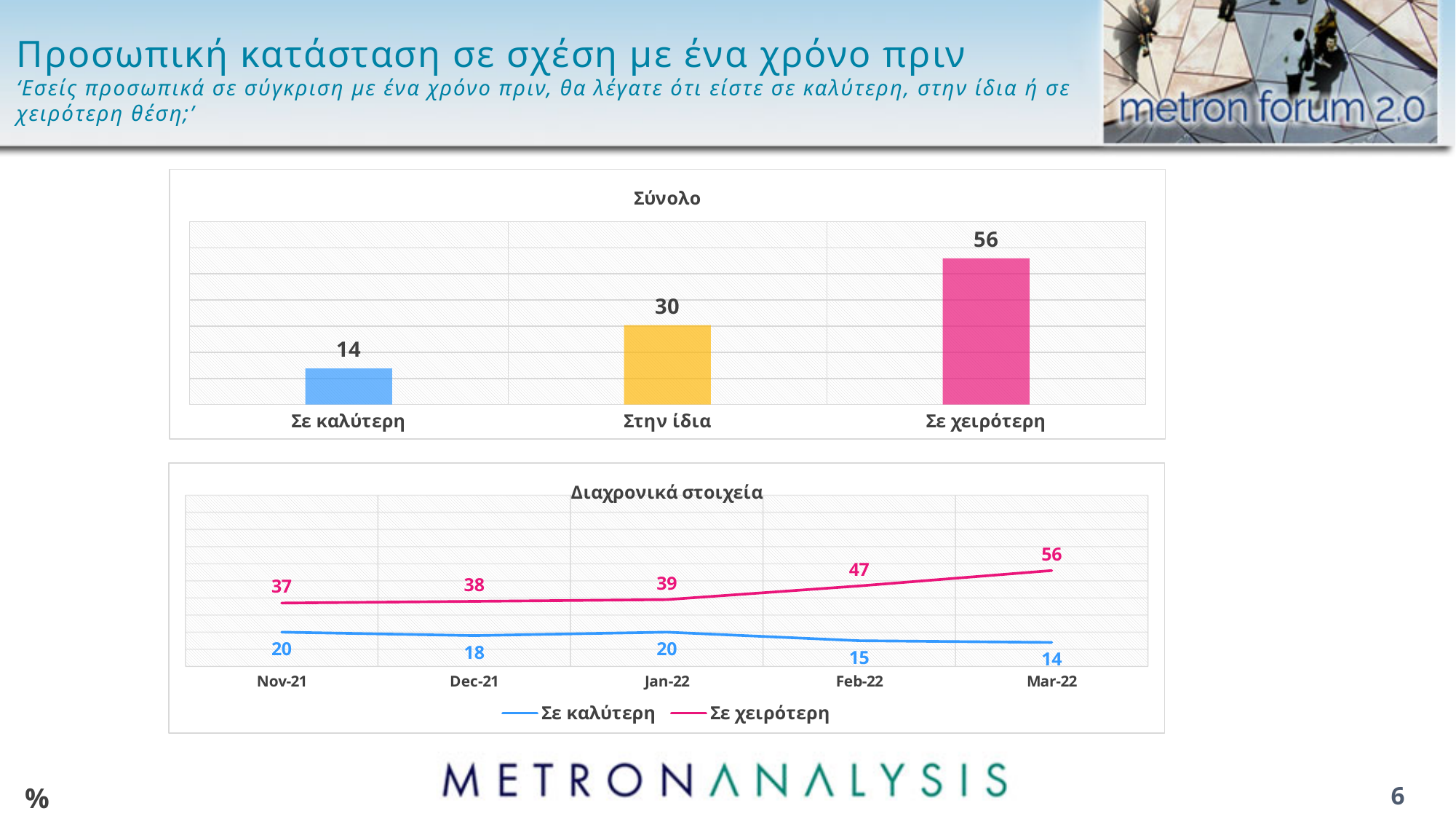
In the 'Σύνολο' chart, what is the value for 'Στην ίδια'? 30 In the 'Σύνολο' chart, which category has the lowest value? Σε καλύτερη In the 'Διαχρονικά στοιχεία' chart, how many series does the legend list? 2 In the 'Διαχρονικά στοιχεία' chart, does the 'Σε χειρότερη' series rise or fall from Nov-21 to Mar-22? Rise In the 'Σύνολο' chart, what is the difference between 'Σε χειρότερη' and 'Σε καλύτερη'? 42 In the 'Διαχρονικά στοιχεία' chart, what is the difference between 'Σε χειρότερη' and 'Σε καλύτερη' in Mar-22? 42 In the 'Διαχρονικά στοιχεία' chart, what is the value for 'Σε χειρότερη' in Feb-22? 47 In the 'Σύνολο' chart, how many categories are shown? 3 In the 'Διαχρονικά στοιχεία' chart, how many time points are shown on the x axis? 5 What kind of chart is the 'Σύνολο' chart? Bar chart In the 'Διαχρονικά στοιχεία' chart, what is the value for 'Σε καλύτερη' in Dec-21? 18 In the 'Σύνολο' chart, what is the value for 'Σε χειρότερη'? 56